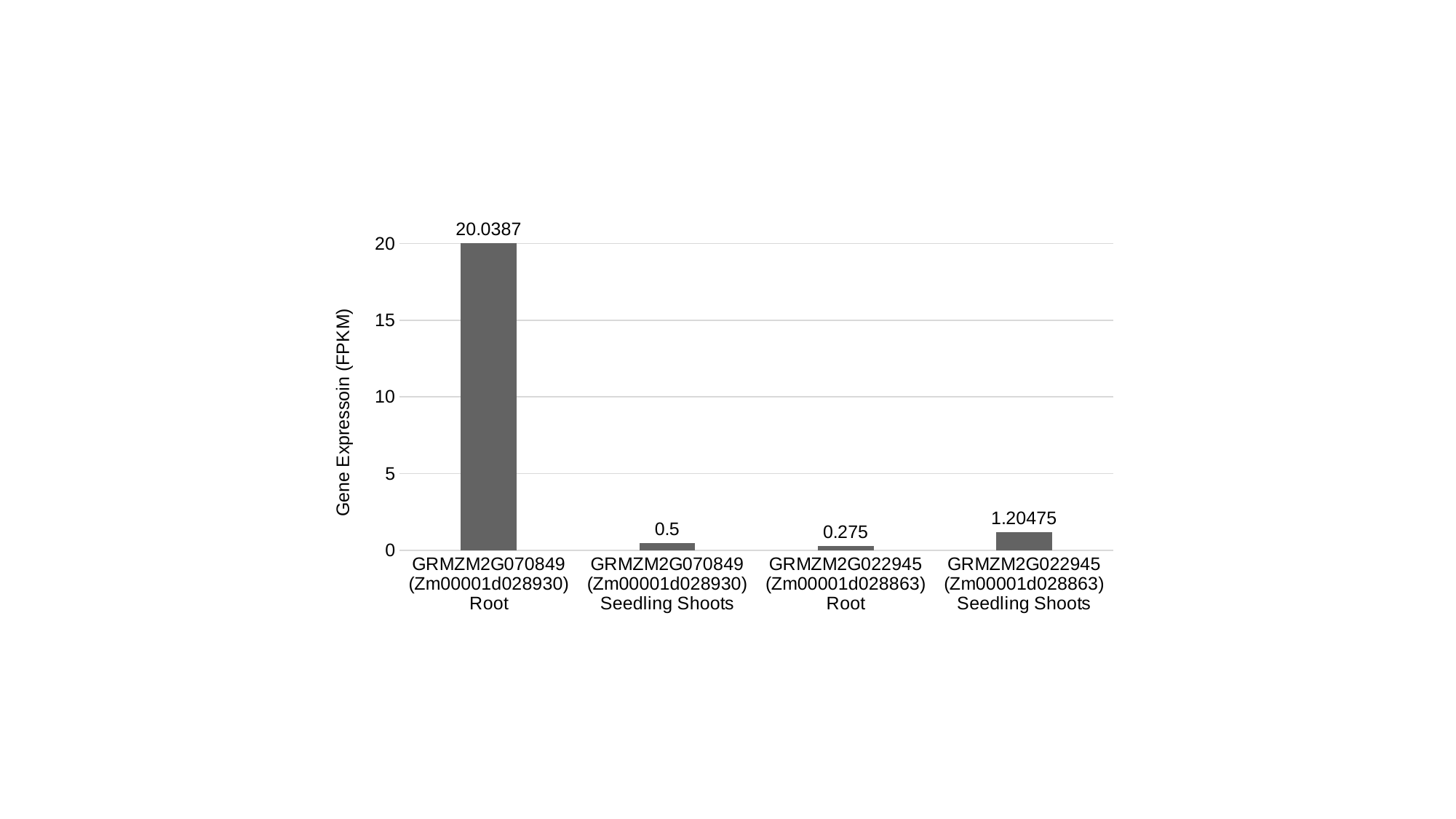
What is the gene expression value for GRMZM2G022945 (Zm00001d028863) Root? 0.275 What is the gene expression value for GRMZM2G022945 (Zm00001d028863) Seedling Shoots? 1.20475 What is the gene expression value for GRMZM2G070849 (Zm00001d028930) Seedling Shoots? 0.5 What is the gene expression value for GRMZM2G070849 (Zm00001d028930) Root? 20.0387 Which is larger, the gene expression value for GRMZM2G022945 Seedling Shoots or GRMZM2G070849 Seedling Shoots? GRMZM2G022945 Seedling Shoots What is the difference between the gene expression values for GRMZM2G070849 Root and GRMZM2G070849 Seedling Shoots? 19.5387 Is the value for GRMZM2G070849 (Zm00001d028930) Root greater or less than 15? greater What kind of chart is shown on the slide? Bar chart What is the difference between the gene expression values for GRMZM2G022945 Seedling Shoots and GRMZM2G022945 Root? 0.92975 Which category has the lowest gene expression value? GRMZM2G022945 (Zm00001d028863) Root Which category has the highest gene expression value? GRMZM2G070849 (Zm00001d028930) Root How many bars are shown in the chart? 4